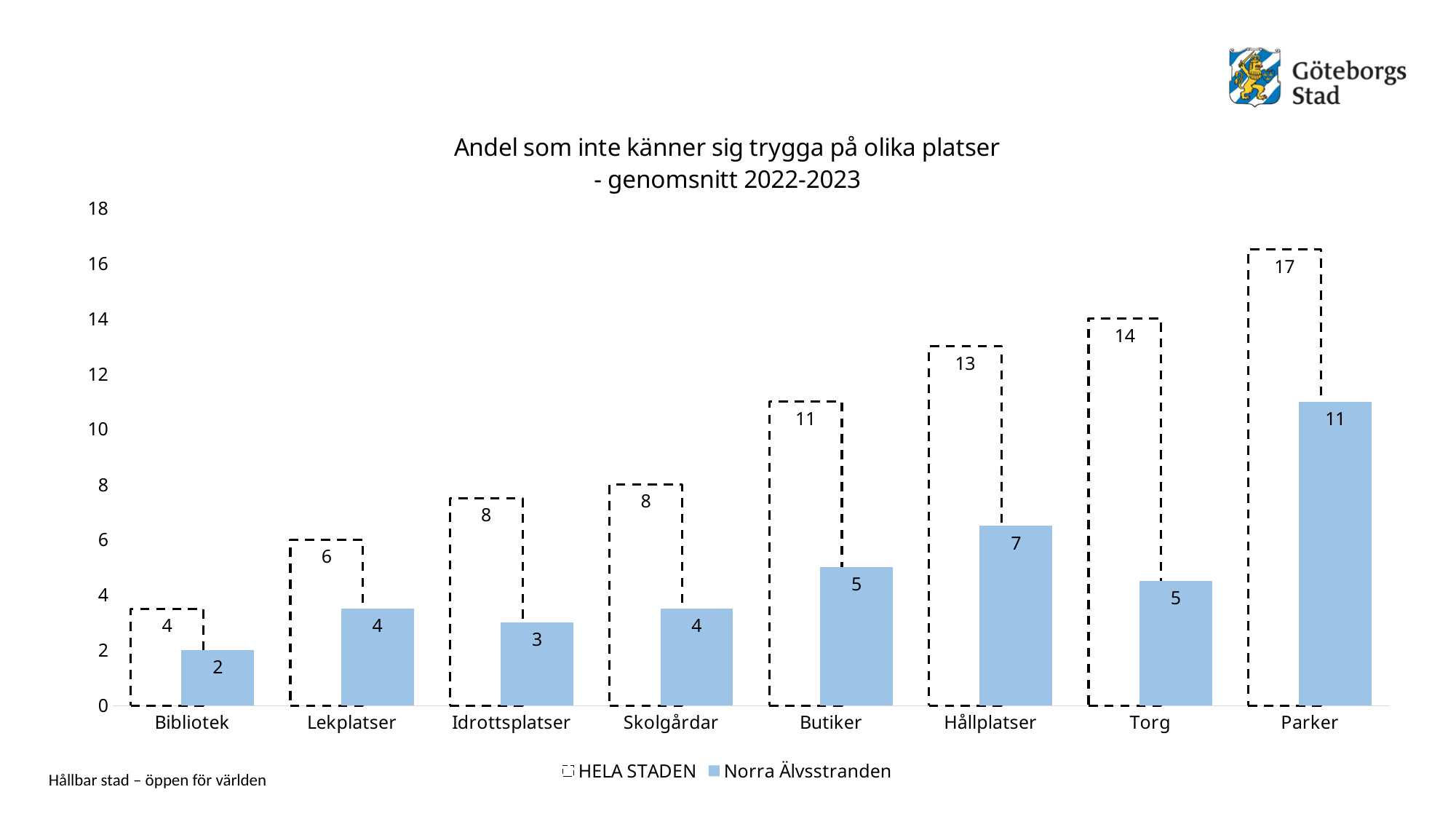
Do the HELA STADEN values rise or fall from Bibliotek to Parker along the x axis? rise What is the difference between HELA STADEN and Norra Älvsstranden at Torg? 9 What is the title of the chart? Andel som inte känner sig trygga på olika platser - genomsnitt 2022-2023 Which category has the lowest value for HELA STADEN? Bibliotek Which category has the highest value for Norra Älvsstranden? Parker What is the value for Norra Älvsstranden at Hållplatser? 7 What is the value for HELA STADEN at Parker? 17 What kind of chart is shown on the slide? bar chart How many series does the legend list? 2 Which is larger at Butiker: HELA STADEN or Norra Älvsstranden? HELA STADEN How many categories are shown on the x axis? 8 What is the value for Norra Älvsstranden at Bibliotek? 2